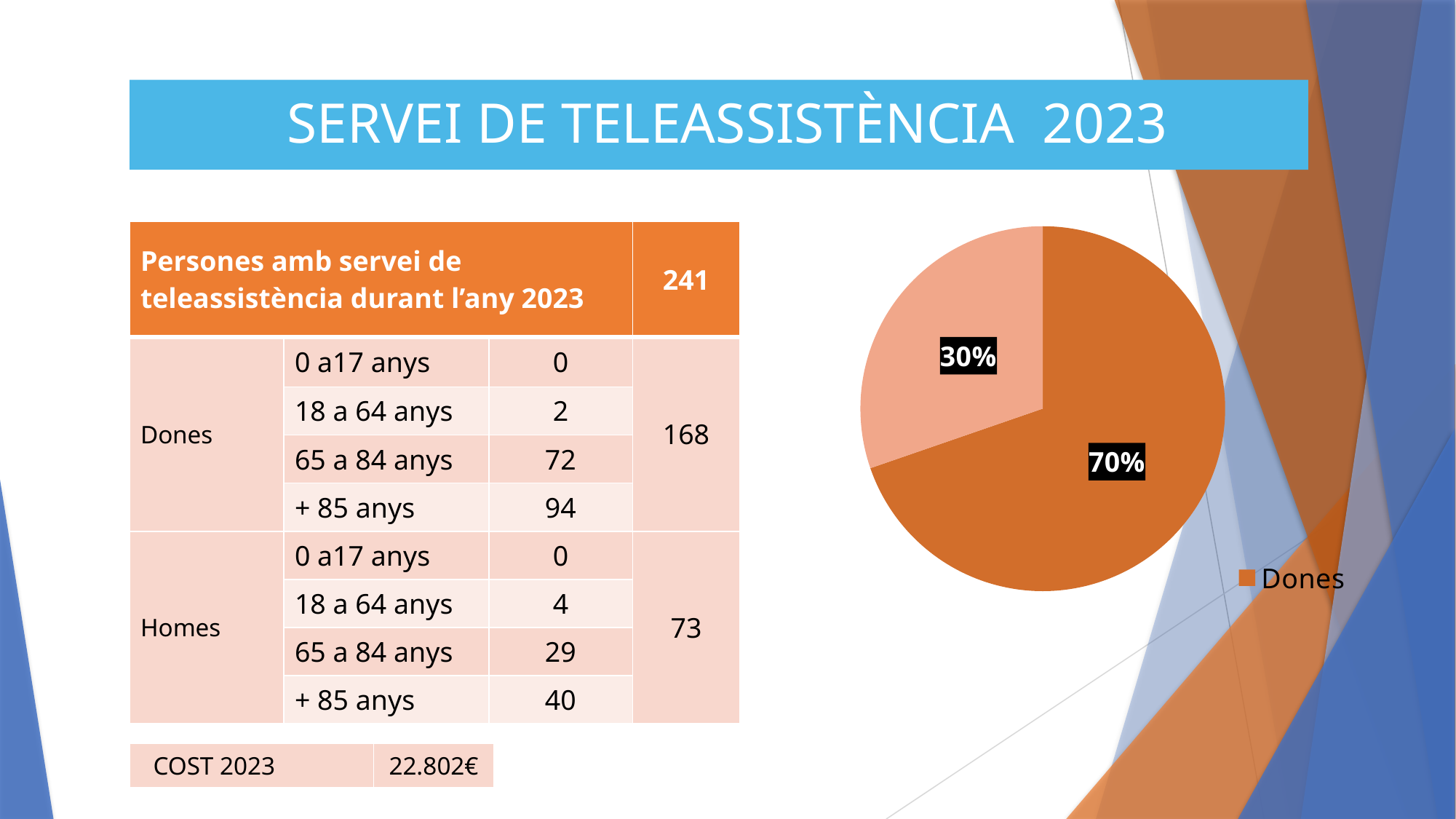
What kind of chart is shown on the right of the slide? pie chart Which legend entry is readable next to the pie chart? Dones What share of the pie chart does the Dones slice represent? 70% Is the share of the Dones slice in the pie chart greater or less than 50%? greater What do the two percentage labels on the pie chart add up to? 100% What is the percentage label printed on the larger, darker slice of the pie chart? 70% What is the percentage shown on the smallest slice of the pie chart? 30% Is the Dones slice of the pie chart larger or smaller than the other slice? larger Which slice of the pie chart is the largest? Dones (70%) What colour is the Dones slice in the pie chart? dark orange How many slices does the pie chart have? 2 What is the difference in percentage points between the two slices of the pie chart? 40 percentage points